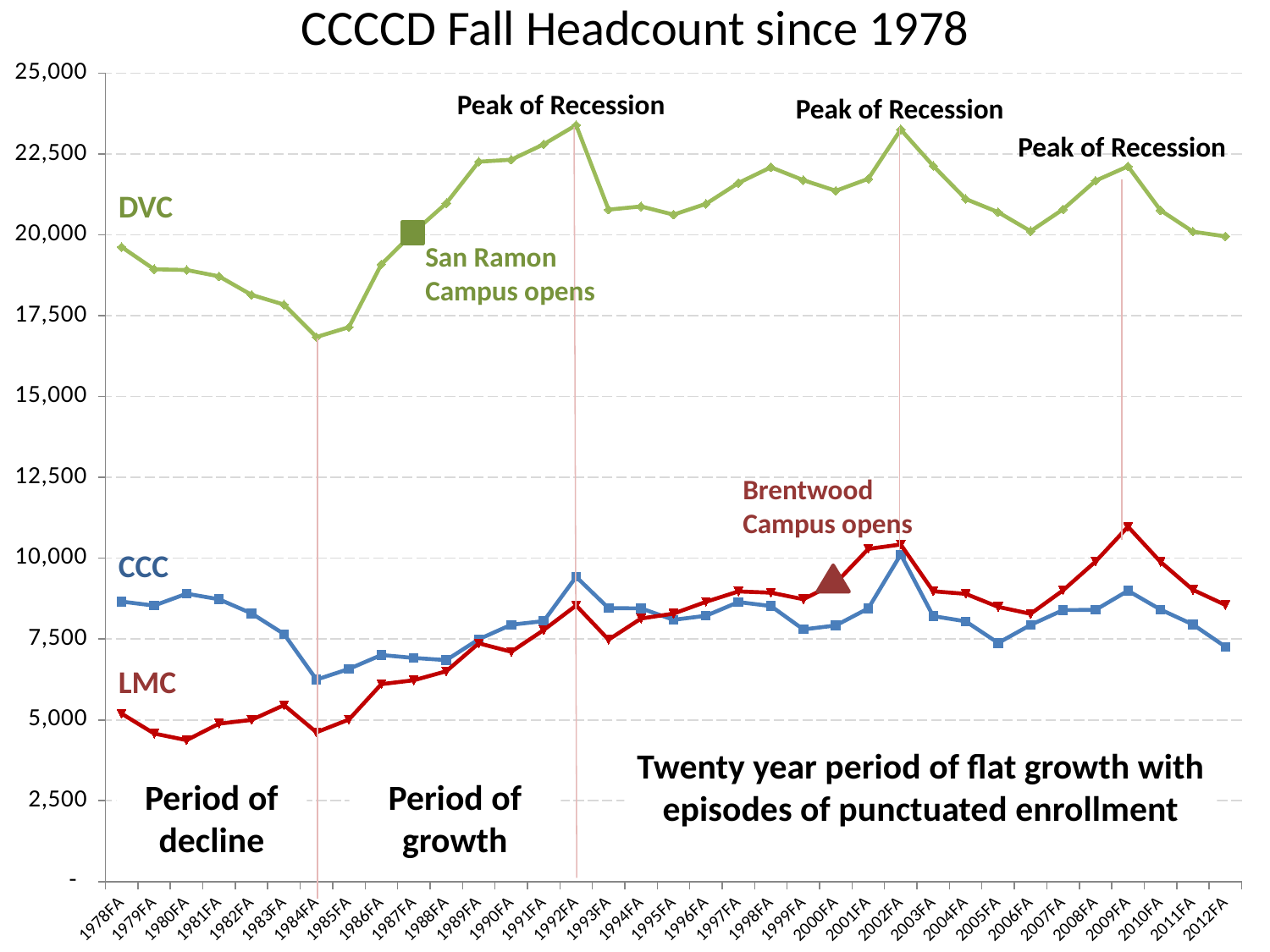
Is the DVC headcount for 1992FA greater or less than 22,500? greater How many fall terms are shown along the x axis? 35 What is the title of the chart? CCCCD Fall Headcount since 1978 Is the DVC headcount for 1984FA greater or less than 17,500? less Is the LMC headcount for 2009FA greater or less than 10,000? greater In which fall term does the LMC line reach its highest value? 2009FA What kind of chart is shown on the slide? Line chart How many series (colleges) are plotted on the chart? 3 In which fall term does the CCC line reach its highest value? 2002FA Does the DVC headcount rise or fall from 1978FA to 1984FA? Fall Which college has the larger headcount in 2012FA, CCC or LMC? LMC